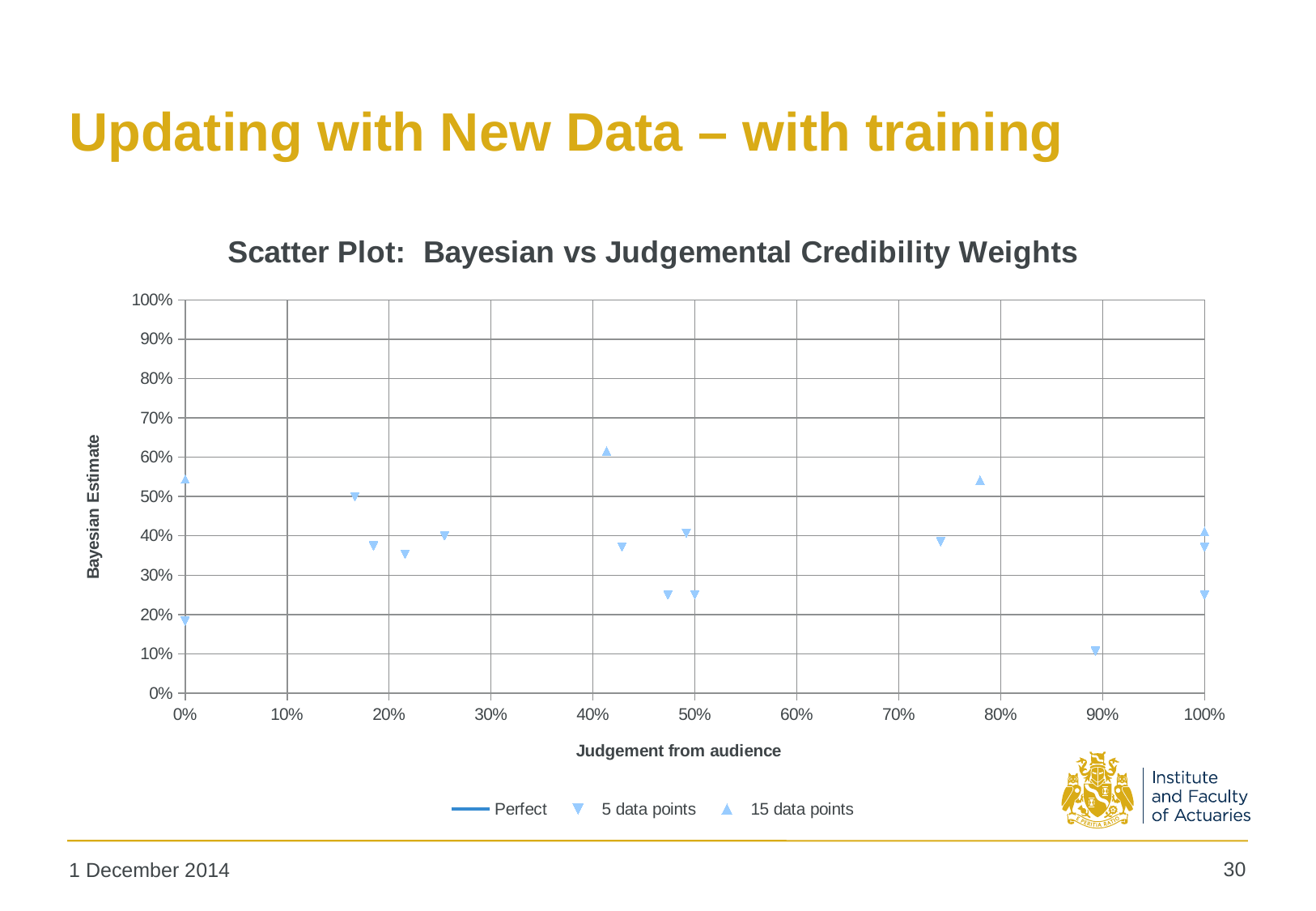
What kind of chart is shown on the slide? Scatter plot What is the title of the chart? Scatter Plot: Bayesian vs Judgemental Credibility Weights Which series contains the point with the lowest Bayesian Estimate? 5 data points Is the Bayesian Estimate for the '15 data points' marker near 80% judgement greater or less than 50%? greater Is the Bayesian Estimate for the '5 data points' marker near 50% judgement with the lower value greater or less than 30%? less How many series does the legend list? 3 What is the label of the horizontal axis? Judgement from audience Which series has the higher Bayesian Estimate at 0% judgement from audience: '5 data points' or '15 data points'? 15 data points Is the Bayesian Estimate for the '5 data points' marker near 90% judgement greater or less than 20%? less Which series contains the point with the highest Bayesian Estimate? 15 data points